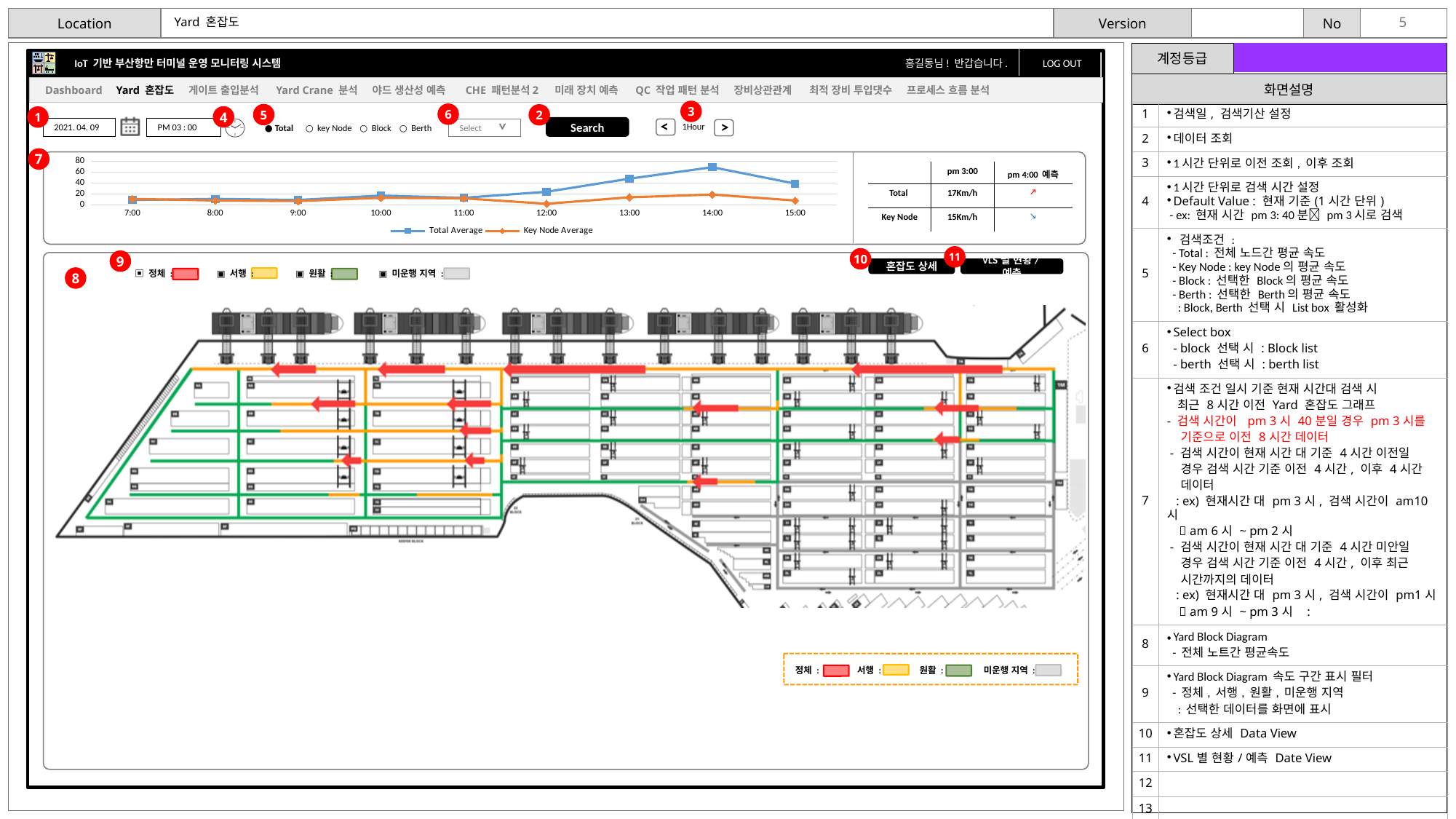
How many time points are plotted along the x axis of the line chart? 9 Does the Total Average series rise or fall between 12:00 and 14:00? rise Is the Total Average value at 7:00 greater or less than 20? less How many series does the legend of the line chart list? 2 Does the Total Average series rise or fall between 14:00 and 15:00? fall At which time does the Total Average series reach its highest value? 14:00 What are the two series named in the line chart's legend? Total Average and Key Node Average At 12:00, which series has the larger value, Total Average or Key Node Average? Total Average Is the Total Average value at 14:00 greater or less than 60? greater Is the Key Node Average value at 14:00 greater or less than 40? less At 14:00, which series has the larger value, Total Average or Key Node Average? Total Average What kind of chart is shown at the top of the screen mockup? line chart